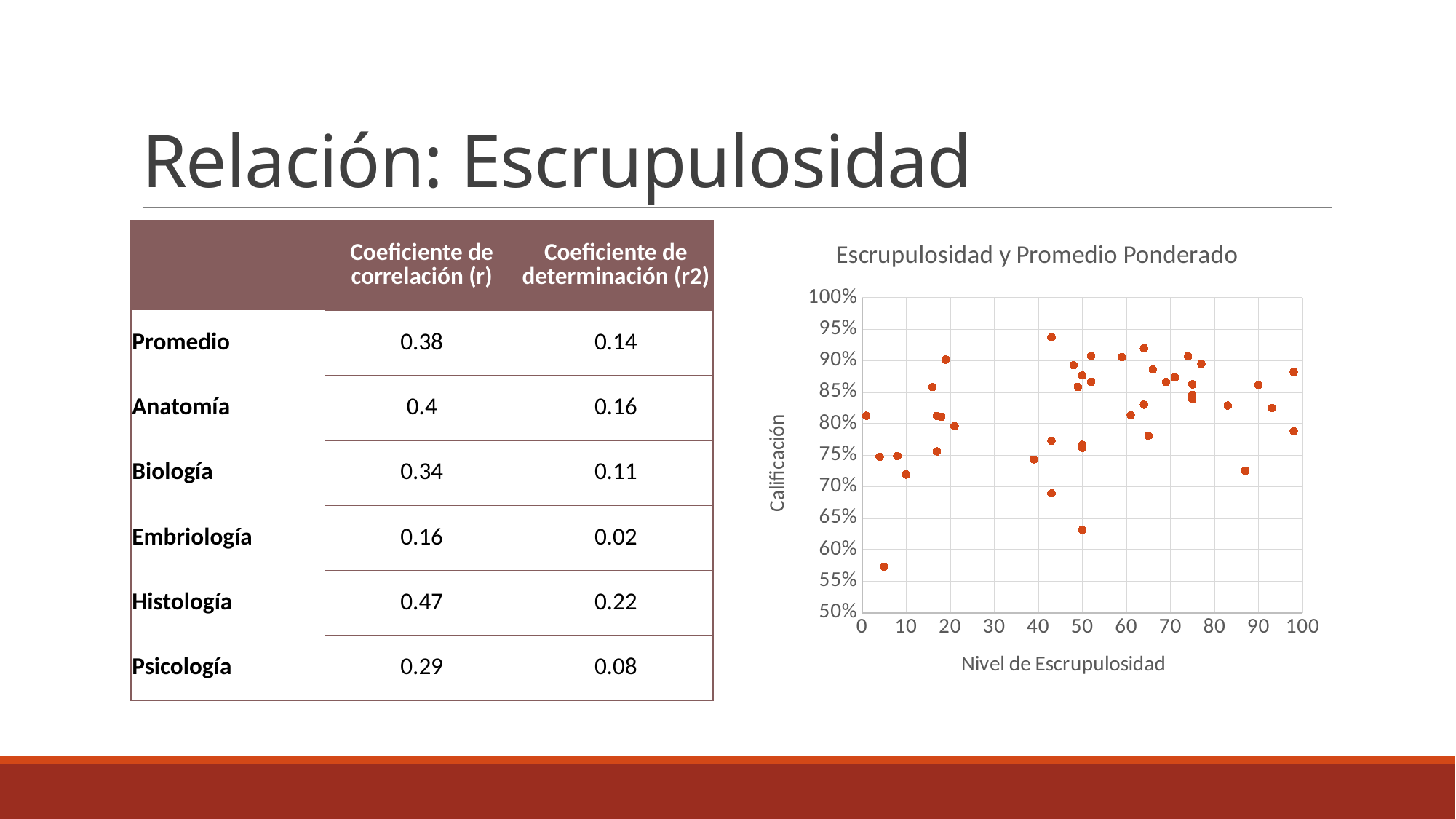
What is the title of the chart on the slide? Escrupulosidad y Promedio Ponderado What is the label of the x axis of the chart? Nivel de Escrupulosidad Is the Calificación of the highest point in the chart greater or less than 90%? greater Do the Calificación values in the chart generally rise or fall as Nivel de Escrupulosidad increases? Rise Is the Calificación of the lowest point in the chart greater or less than 60%? less What kind of chart is shown on the slide? Scatter chart Are the Calificación values of all points with Nivel de Escrupulosidad above 60 greater or less than 70%? greater